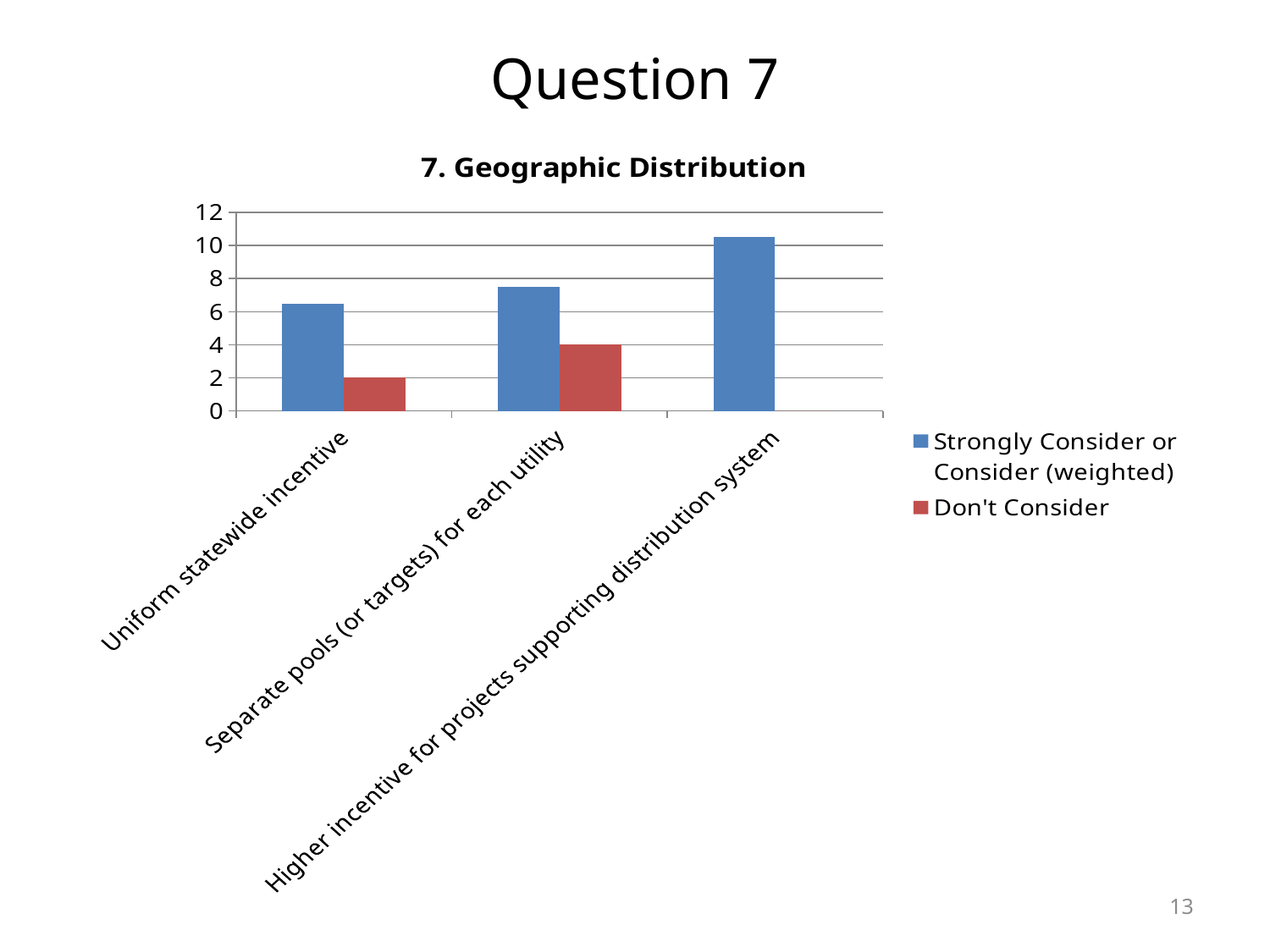
How many series does the legend list? 2 What is the Don't Consider value for Separate pools (or targets) for each utility? 4 What kind of chart is shown on the slide? bar chart What is the Don't Consider value for Uniform statewide incentive? 2 Do the Strongly Consider or Consider (weighted) values rise or fall from left to right across the categories? rise Is the Strongly Consider or Consider (weighted) value for Higher incentive for projects supporting distribution system greater or less than 10? greater What is the title of the chart? 7. Geographic Distribution Is the Strongly Consider or Consider (weighted) value for Uniform statewide incentive greater or less than 8? less Which category has the highest Strongly Consider or Consider (weighted) value? Higher incentive for projects supporting distribution system How many categories are shown on the x axis? 3 Which category has the lowest Strongly Consider or Consider (weighted) value? Uniform statewide incentive Which is larger for Separate pools (or targets) for each utility: the Strongly Consider or Consider (weighted) value or the Don't Consider value? Strongly Consider or Consider (weighted)